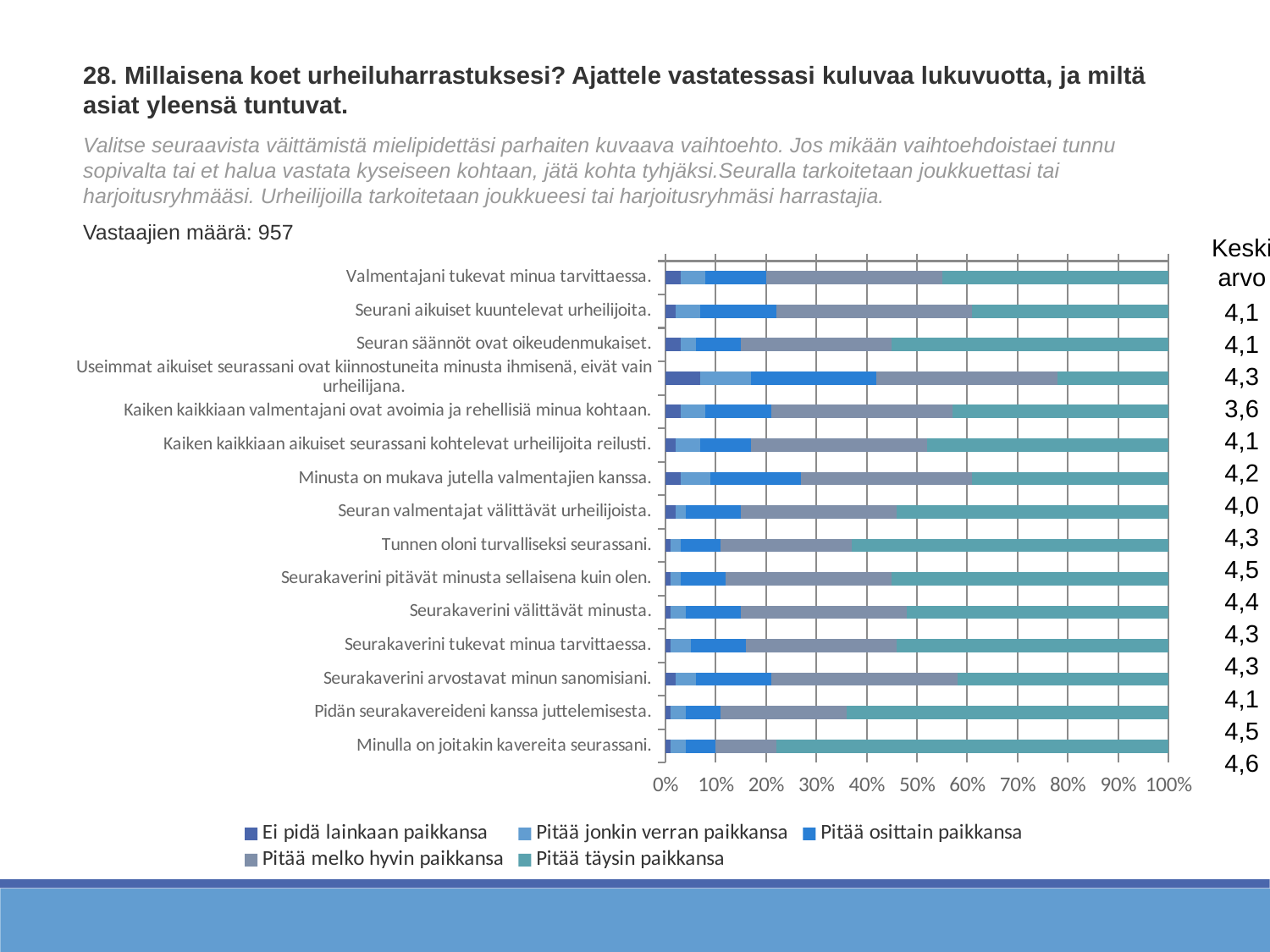
What is the maximum value shown on the horizontal axis of the chart? 100% Is the 'Pitää täysin paikkansa' share for 'Useimmat aikuiset seurassani ovat kiinnostuneita minusta ihmisenä, eivät vain urheilijana.' greater or less than 30%? less How many statements (categories) are plotted on the chart? 15 How many respondents (Vastaajien määrä) are reported for the chart? 957 How many series does the chart legend list? 5 Which statement has the larger 'Pitää täysin paikkansa' share: 'Minulla on joitakin kavereita seurassani.' or 'Useimmat aikuiset seurassani ovat kiinnostuneita minusta ihmisenä, eivät vain urheilijana.'? Minulla on joitakin kavereita seurassani. Which statement has the largest 'Pitää täysin paikkansa' share? Minulla on joitakin kavereita seurassani. What is the first entry in the chart legend? Ei pidä lainkaan paikkansa What kind of chart is shown on the slide? Stacked bar chart Is the 'Pitää täysin paikkansa' share for 'Tunnen oloni turvalliseksi seurassani.' greater or less than 50%? greater Which statement has the smallest 'Pitää täysin paikkansa' share? Useimmat aikuiset seurassani ovat kiinnostuneita minusta ihmisenä, eivät vain urheilijana. Is the 'Pitää täysin paikkansa' share for 'Minulla on joitakin kavereita seurassani.' greater or less than 70%? greater